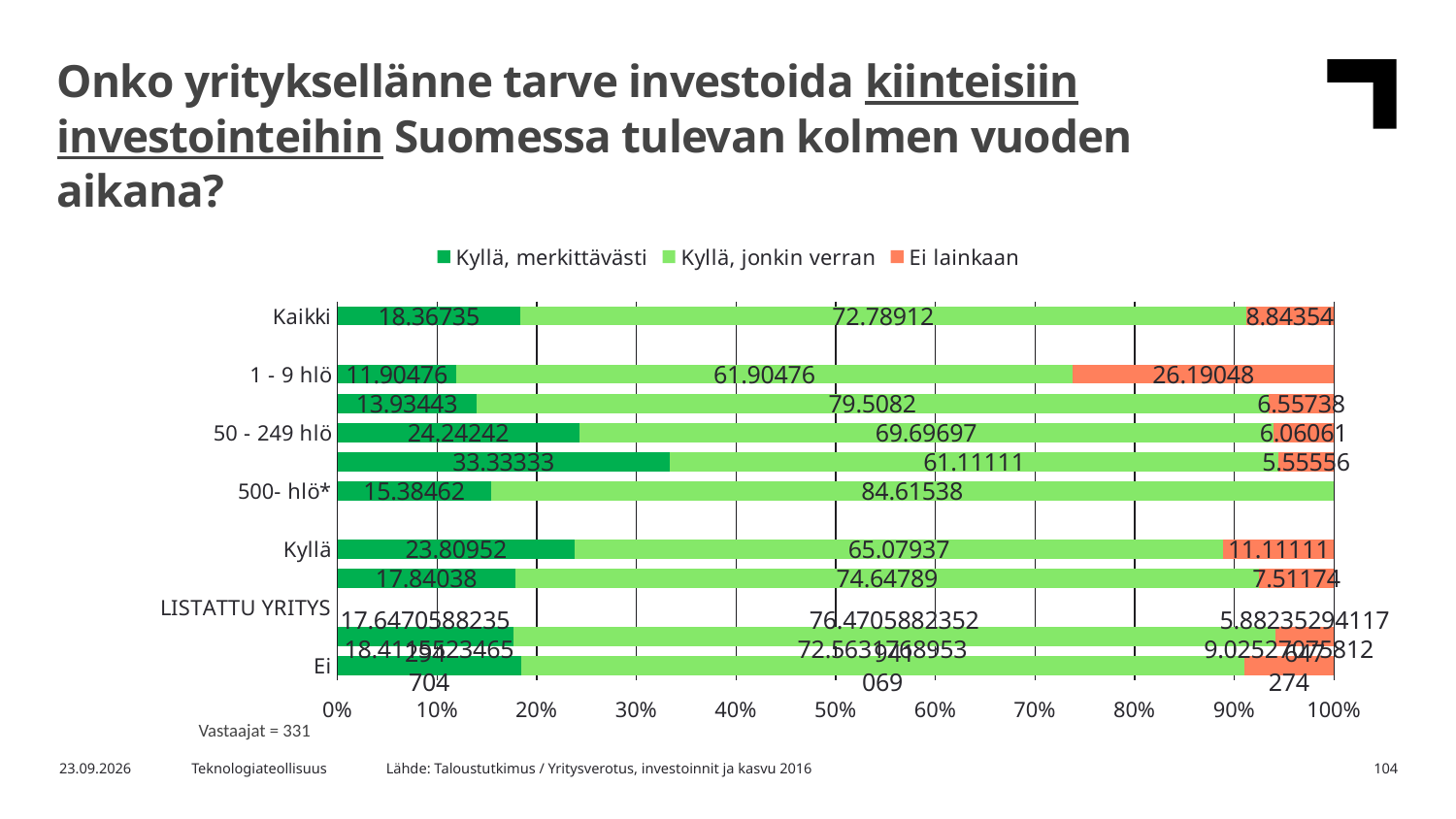
What is the value of 'Ei lainkaan' for 1 - 9 hlö? 26.19048 What is the value of 'Ei lainkaan' for Kyllä? 11.11111 How many series does the legend list? 3 What is the value of 'Kyllä, merkittävästi' for Kaikki? 18.36735 What is the value of 'Kyllä, merkittävästi' for 50 - 249 hlö? 24.24242 What is the value of 'Kyllä, jonkin verran' for 500- hlö*? 84.61538 What kind of chart is shown on the slide? Stacked bar chart Which of the labelled categories has the highest 'Ei lainkaan' value? 1 - 9 hlö Which is larger, the 'Kyllä, merkittävästi' value for 50 - 249 hlö or for Kaikki? 50 - 249 hlö How many respondents (Vastaajat) does the slide report? 331 What is the difference between the 'Kyllä, jonkin verran' and 'Kyllä, merkittävästi' values for Kaikki? 54.42177 What is the value of 'Kyllä, jonkin verran' for Kaikki? 72.78912